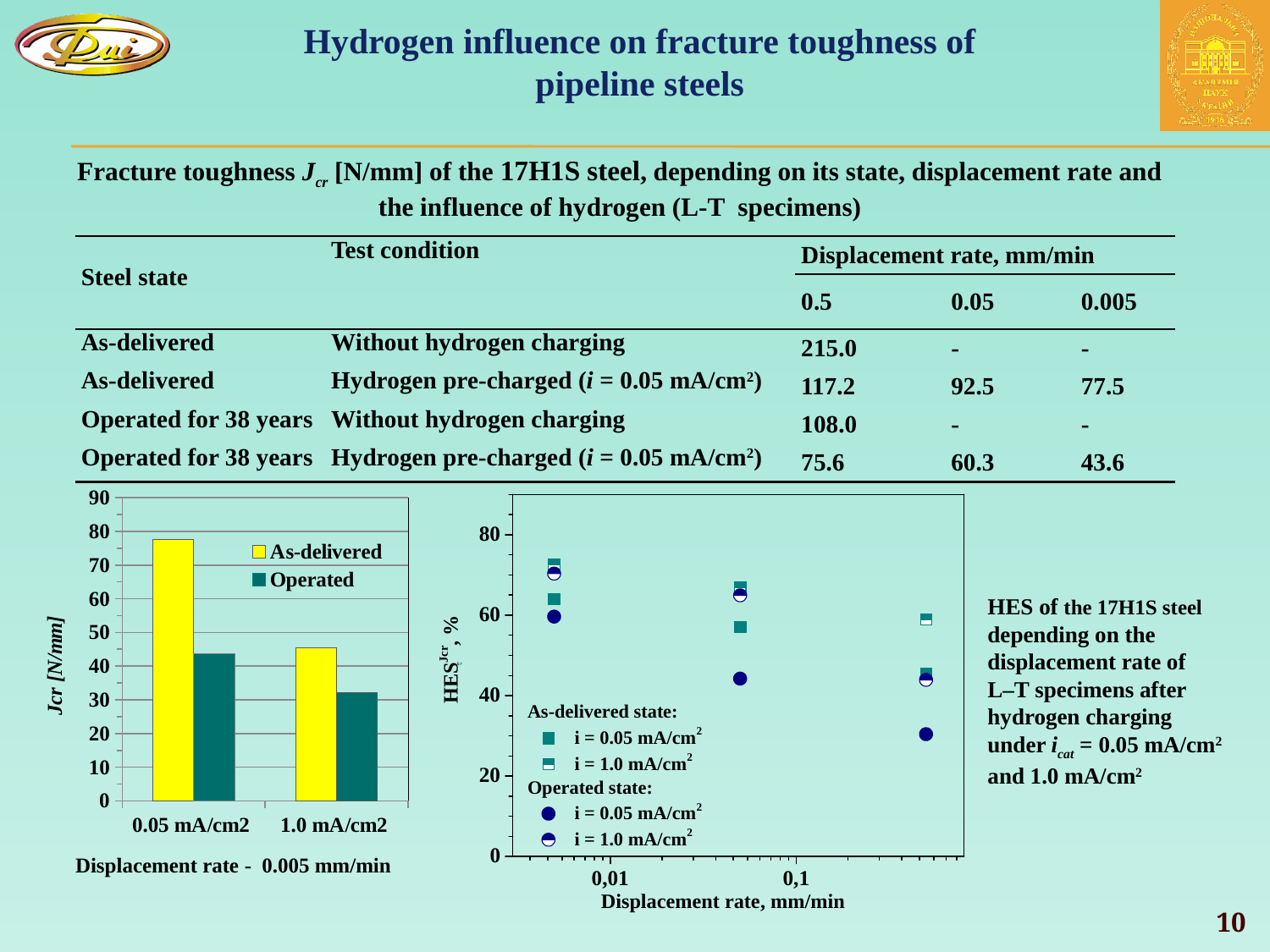
What kind of chart is the right chart showing HES versus displacement rate? scatter chart In the left bar chart, how many categories are shown on the x axis? 2 In the right scatter chart, how many series does the legend list? 4 In the left bar chart, which bar is the highest? As-delivered at 0.05 mA/cm2 In the left bar chart, at 0.05 mA/cm2, which is larger: As-delivered or Operated? As-delivered What is the y-axis label of the left bar chart? Jcr [N/mm] In the left bar chart, is the Operated value at 1.0 mA/cm2 greater or less than 40? less In the right scatter chart, do the HES values rise or fall as the displacement rate increases? fall In the left bar chart, which bar is the lowest? Operated at 1.0 mA/cm2 In the left bar chart, how many series does the legend list? 2 In the left bar chart, is the As-delivered value at 0.05 mA/cm2 greater or less than 70? greater What kind of chart is the left chart showing Jcr [N/mm]? bar chart